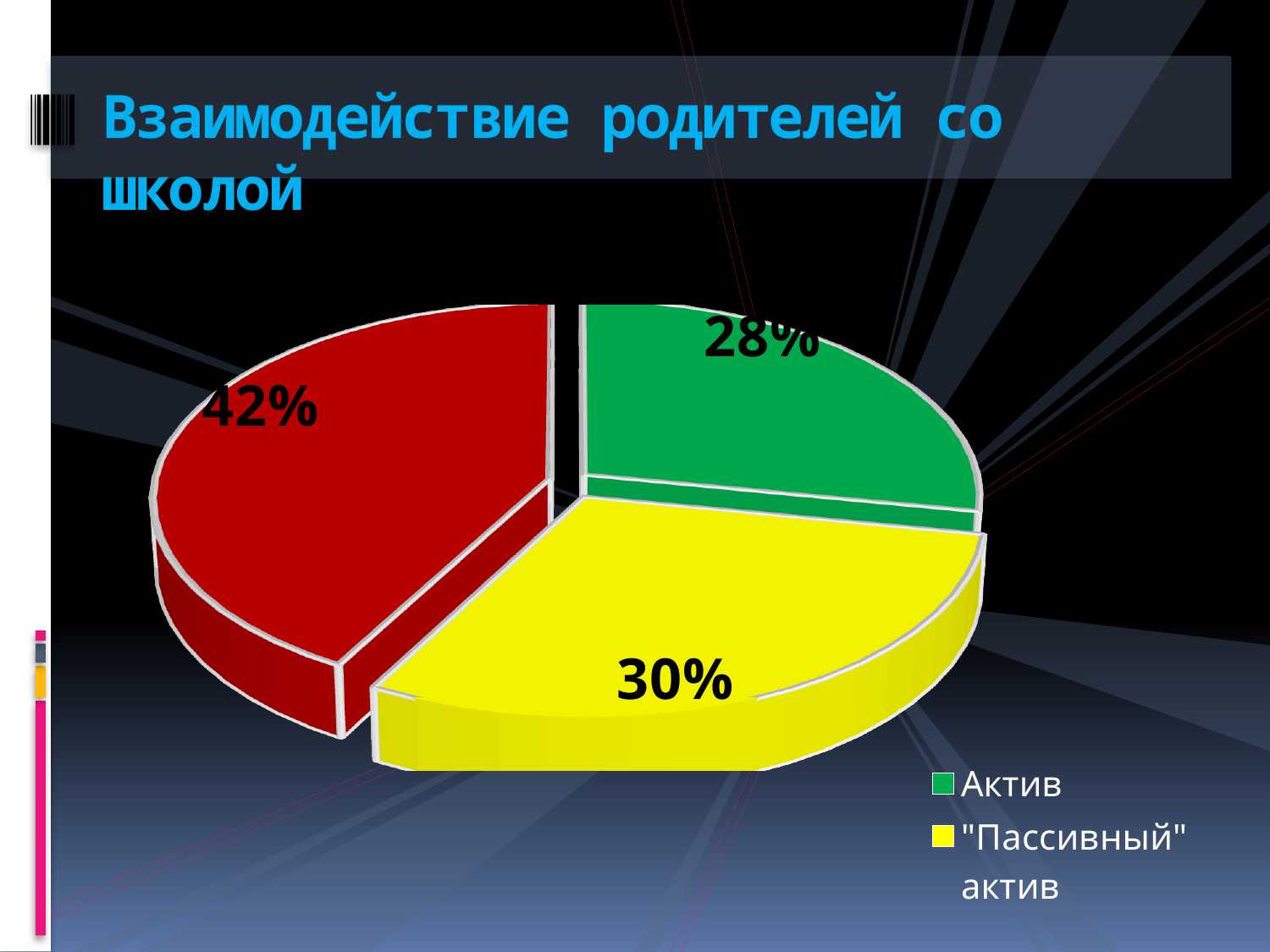
What kind of chart is shown on the slide? pie chart Which of the labelled categories has the smallest slice? Актив How many entries does the legend list? 2 What is the difference between the "Пассивный" актив slice and the Актив slice? 2% What is the value of the largest slice in the pie chart? 42% What is the title of the slide? Взаимодействие родителей со школой Which is larger, Актив or "Пассивный" актив? "Пассивный" актив How many slices does the pie chart have? 3 What percentage is shown for Актив? 28% What percentage is shown for "Пассивный" актив? 30% What share of the pie does the red slice represent? 42% What colour is the Актив slice? green